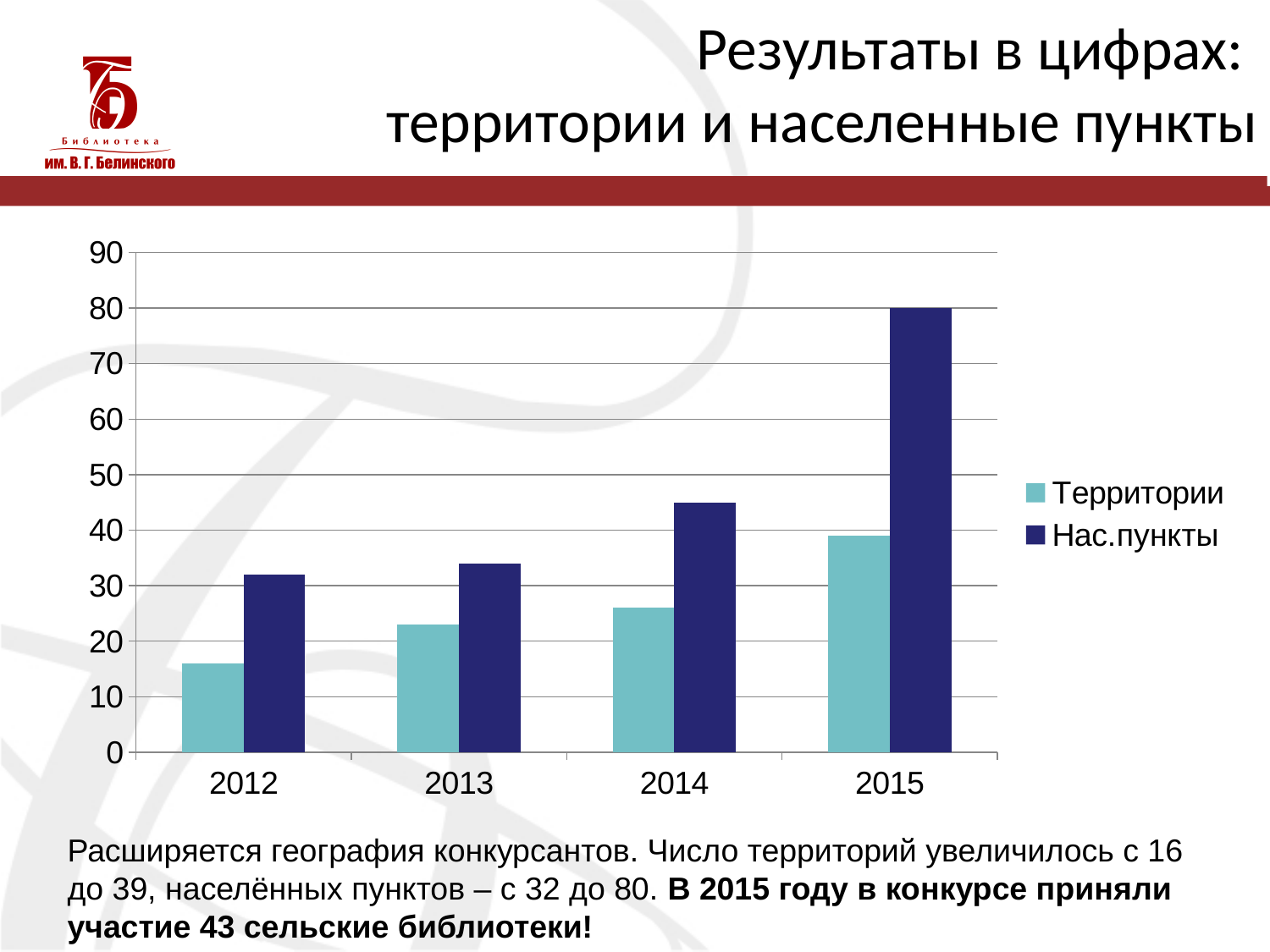
What is the value for Нас.пункты in 2012? 32 In which year is the Территории value lowest? 2012 How many years are shown on the x axis? 4 What is the value for Нас.пункты in 2015? 80 What kind of chart is shown on the slide? bar chart By how much did Нас.пункты increase from 2012 to 2015? 48 What is the value for Территории in 2012? 16 How many series does the legend list? 2 In which year is the Нас.пункты value highest? 2015 What is the value for Территории in 2015? 39 Do the Территории values rise or fall from 2012 to 2015? rise Is the value for Нас.пункты in 2014 greater or less than 40? greater